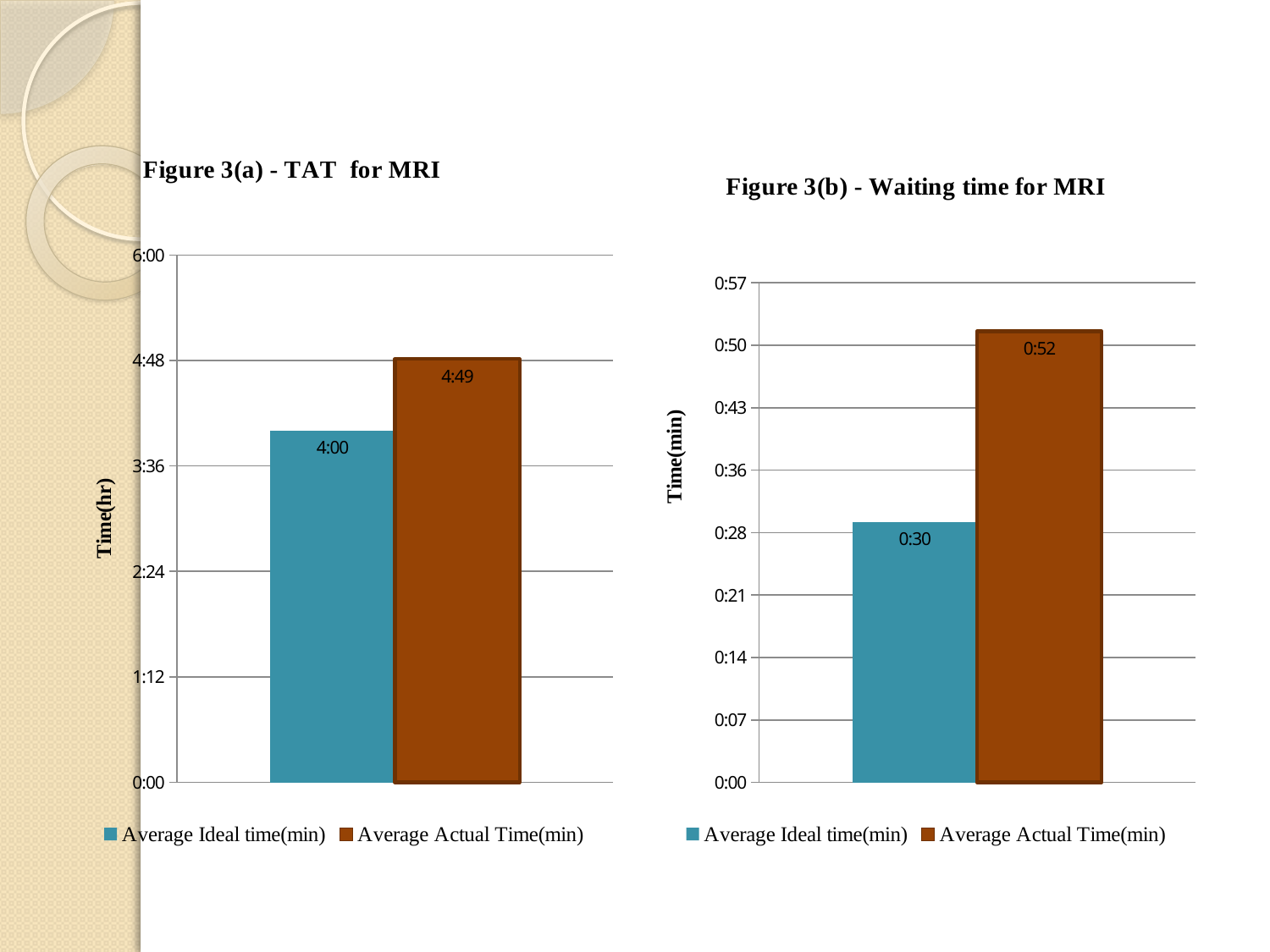
In Figure 3(a) - TAT for MRI, what is the value for Average Ideal time(min)? 4:00 In Figure 3(b) - Waiting time for MRI, what is the difference between Average Actual Time(min) and Average Ideal time(min)? 0:22 What is the y-axis label of Figure 3(b) - Waiting time for MRI? Time(min) In Figure 3(b) - Waiting time for MRI, is the value for Average Actual Time(min) greater or less than 0:43? greater In Figure 3(b) - Waiting time for MRI, what is the value for Average Ideal time(min)? 0:30 In Figure 3(a) - TAT for MRI, is the value for Average Ideal time(min) greater or less than 4:48? less How many series does the legend of Figure 3(b) - Waiting time for MRI list? 2 In Figure 3(b) - Waiting time for MRI, what is the value for Average Actual Time(min)? 0:52 In Figure 3(a) - TAT for MRI, what is the value for Average Actual Time(min)? 4:49 In Figure 3(b) - Waiting time for MRI, which series has the lower value? Average Ideal time(min) What kind of chart is Figure 3(a) - TAT for MRI? Bar chart In Figure 3(a) - TAT for MRI, which series has the higher value? Average Actual Time(min)